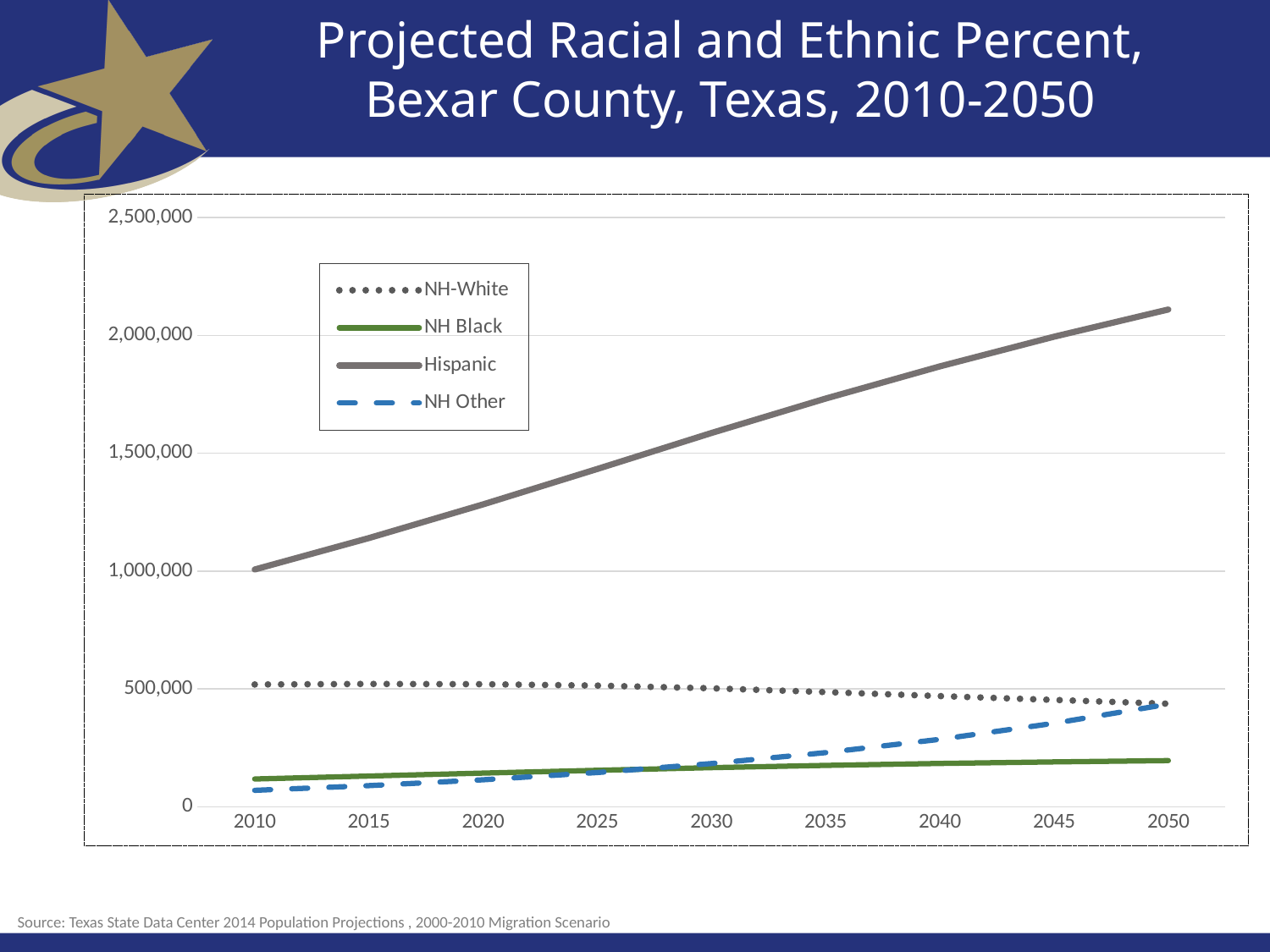
How many series does the legend list? 4 In 2050, which is larger: NH Other or NH Black? NH Other Does the Hispanic series rise or fall from 2010 to 2050? Rise How many year labels are shown along the x axis? 9 Is the value for NH Black in 2050 greater or less than 500,000? less What kind of chart is shown on the slide? Line chart Which series is drawn with a dotted line in the legend? NH-White Is the value for Hispanic in 2020 greater or less than 1,500,000? less Is the value for Hispanic in 2050 greater or less than 2,000,000? greater Does the NH-White series rise or fall from 2010 to 2050? Fall Which series has the highest value in 2050? Hispanic Which series has the lowest value in 2010? NH Other